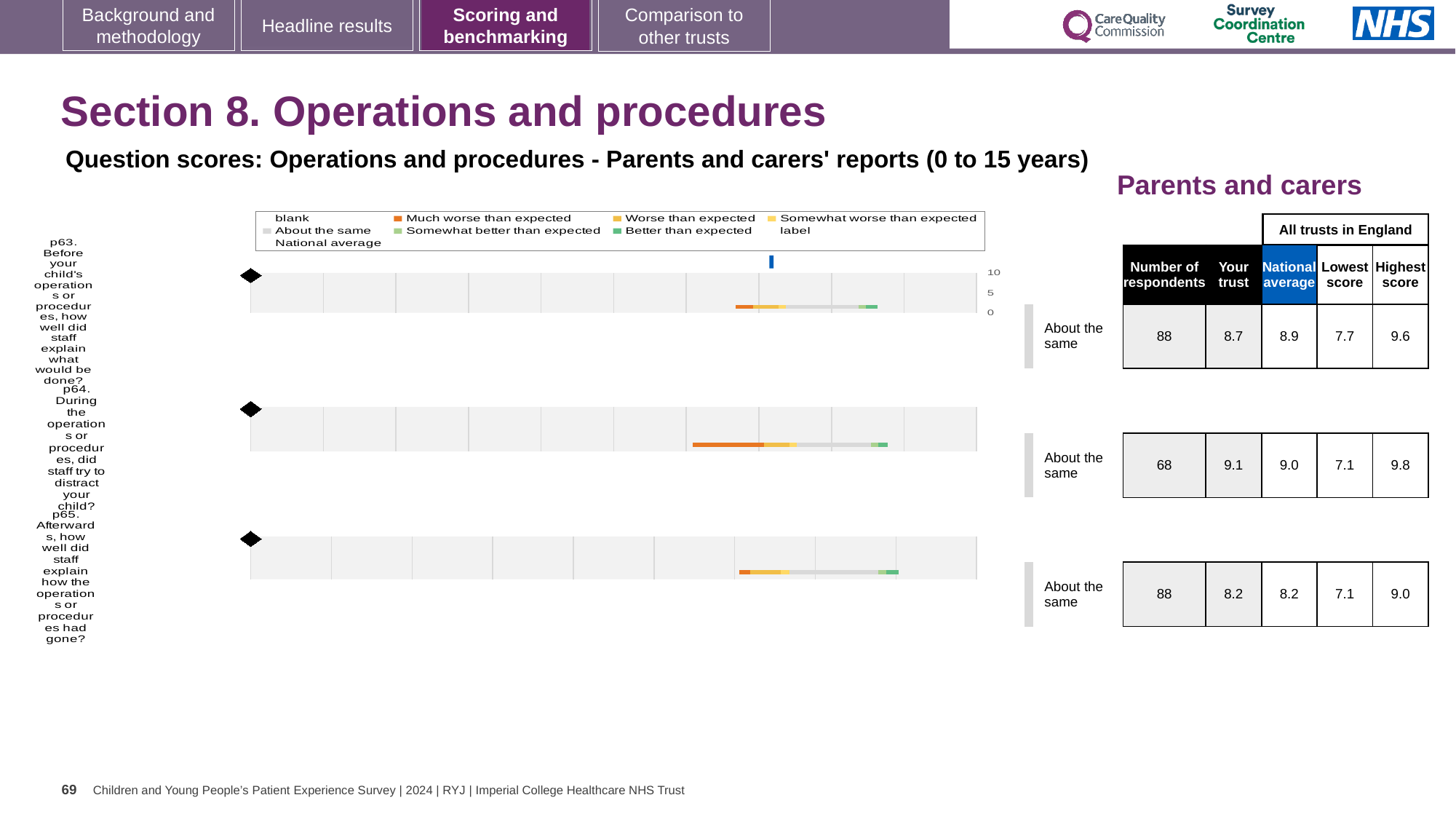
What is the 'Your trust' score for p63 (Before your child's operations or procedures, how well did staff explain what would be done?)? 8.7 In the legend, what colour represents 'Much worse than expected'? Orange What benchmark category is shown for p65? About the same Which question has the lowest 'Your trust' score? p65 What is the highest score among all trusts in England for p65 (Afterwards, how well did staff explain how the operations or procedures had gone?)? 9.0 What kind of chart is used for each question on this slide? Bar chart Which question has the highest 'Your trust' score? p64 What is the national average score for p64 (During the operations or procedures, did staff try to distract your child?)? 9.0 How many survey questions are charted on this slide? 3 How many respondents answered p64? 68 For p63, which is higher: the 'Your trust' score or the national average? National average What is the difference between the highest score and the lowest score for p63? 1.9